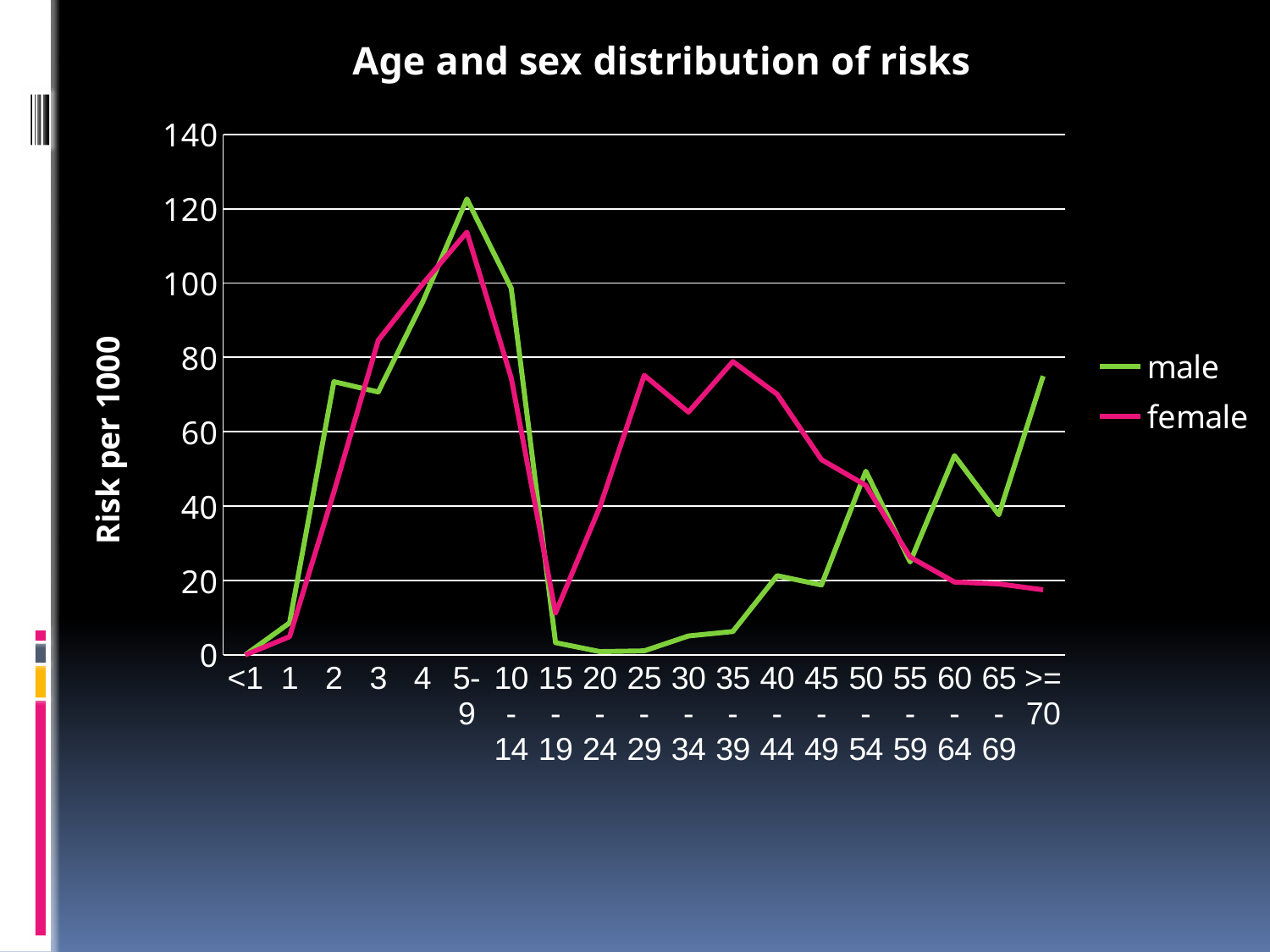
How many series does the legend list? 2 What kind of chart is shown on the slide? line chart Is the male value for the 20-24 age group greater or less than 20? less Is the female value for the 35-39 age group greater or less than 60? greater What is the label of the vertical axis? Risk per 1000 What is the title of the chart? Age and sex distribution of risks Which series has the higher value in the >=70 age group, male or female? male How many age categories are plotted along the x axis? 19 Which series has the higher value in the 25-29 age group, male or female? female Is the male value for the 5-9 age group greater or less than 100? greater In which age category does the female series reach its highest value? 5-9 In which age category does the male series reach its highest value? 5-9